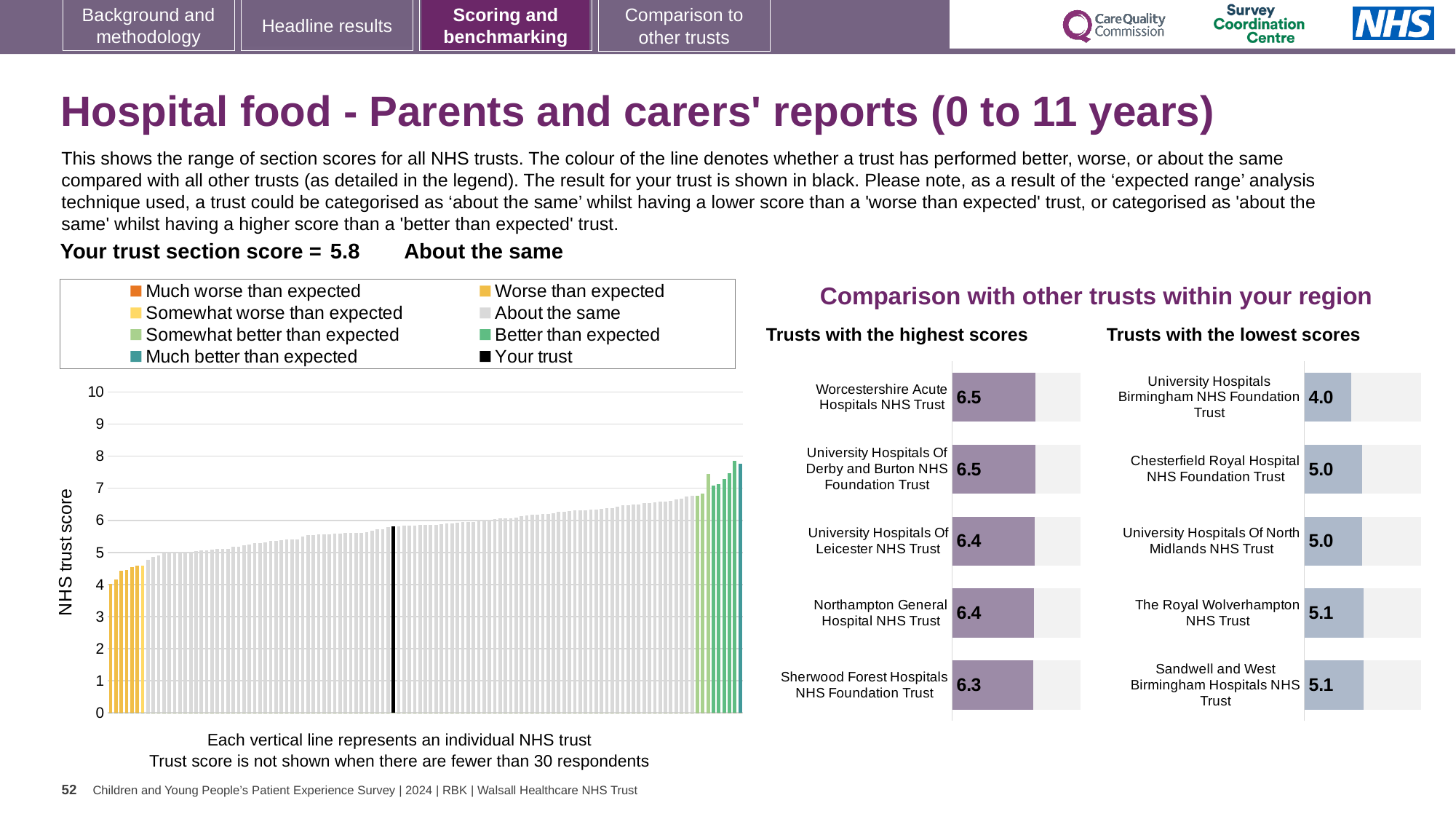
In the large chart on the left, do the trust scores rise or fall from left to right? rise How many entries does the legend above the large chart on the left list? 8 In the 'Trusts with the lowest scores' chart, what is the score for University Hospitals Birmingham NHS Foundation Trust? 4.0 What is the y-axis label of the large chart on the left? NHS trust score In the 'Trusts with the highest scores' chart, what is the difference between the scores of Worcestershire Acute Hospitals NHS Trust and Sherwood Forest Hospitals NHS Foundation Trust? 0.2 How many trusts are shown in the 'Trusts with the lowest scores' chart? 5 In the 'Trusts with the lowest scores' chart, which trust has the lowest score? University Hospitals Birmingham NHS Foundation Trust In the large chart on the left, is the value for your trust (the black bar) greater or less than 5? greater What type of chart is the large chart on the left showing NHS trust scores? bar chart In the 'Trusts with the highest scores' chart, which trust has the lowest score? Sherwood Forest Hospitals NHS Foundation Trust In the large chart on the left, what is the section score for your trust (the black bar)? 5.8 In the 'Trusts with the highest scores' chart, what is the score for Worcestershire Acute Hospitals NHS Trust? 6.5